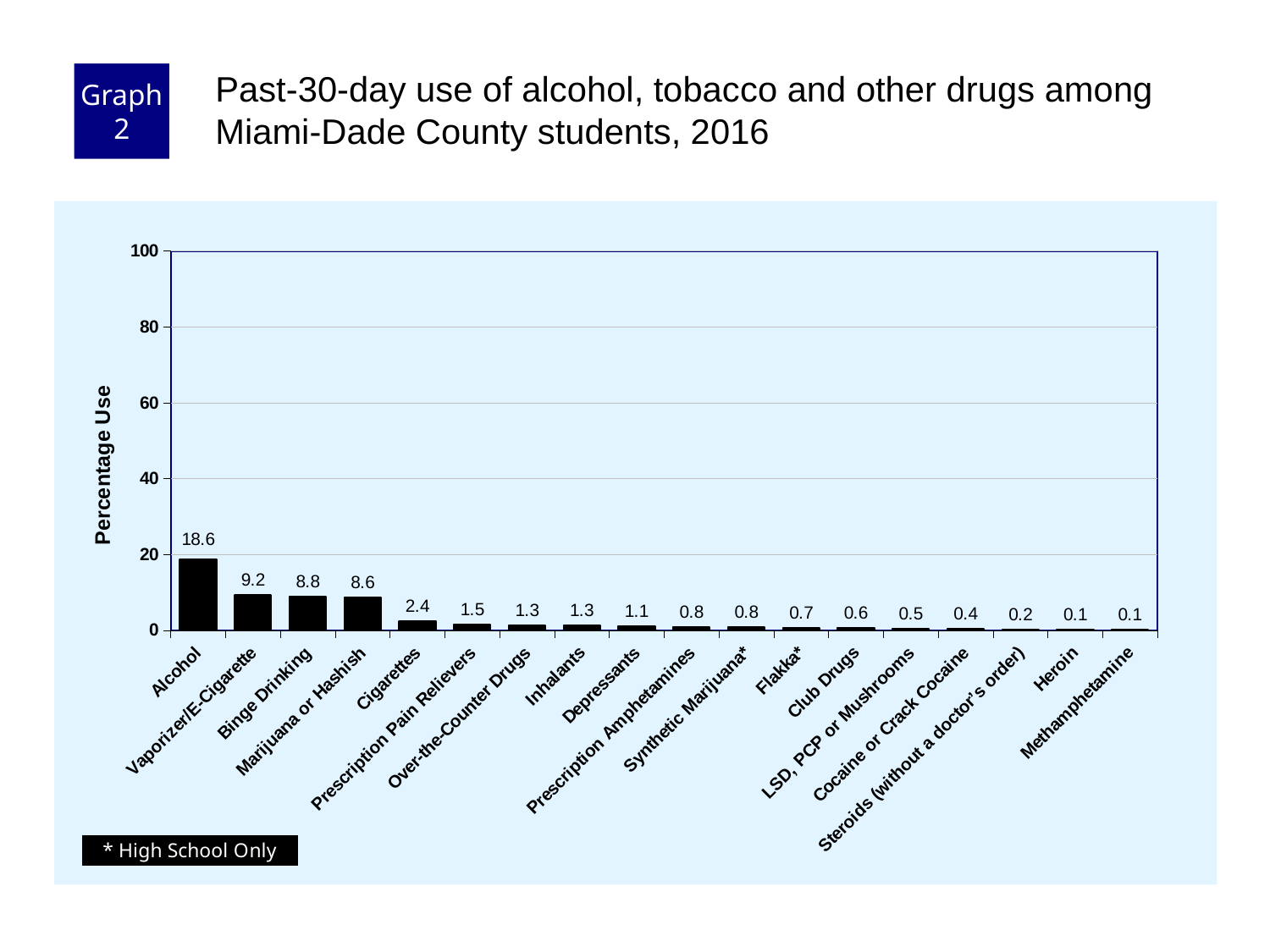
What is the percentage use for Marijuana or Hashish? 8.6 What kind of chart is shown on the slide? Bar chart Which category has the highest percentage use? Alcohol What is the percentage use for Cocaine or Crack Cocaine? 0.4 What is the difference in percentage use between Binge Drinking and Cigarettes? 6.4 Which has a higher percentage use, Binge Drinking or Marijuana or Hashish? Binge Drinking Is the value for Alcohol greater or less than 20? less How many categories are shown on the x axis? 18 What is the percentage use for Alcohol? 18.6 What is the difference in percentage use between Alcohol and Vaporizer/E-Cigarette? 9.4 What is the percentage use for Cigarettes? 2.4 What is the percentage use for Vaporizer/E-Cigarette? 9.2